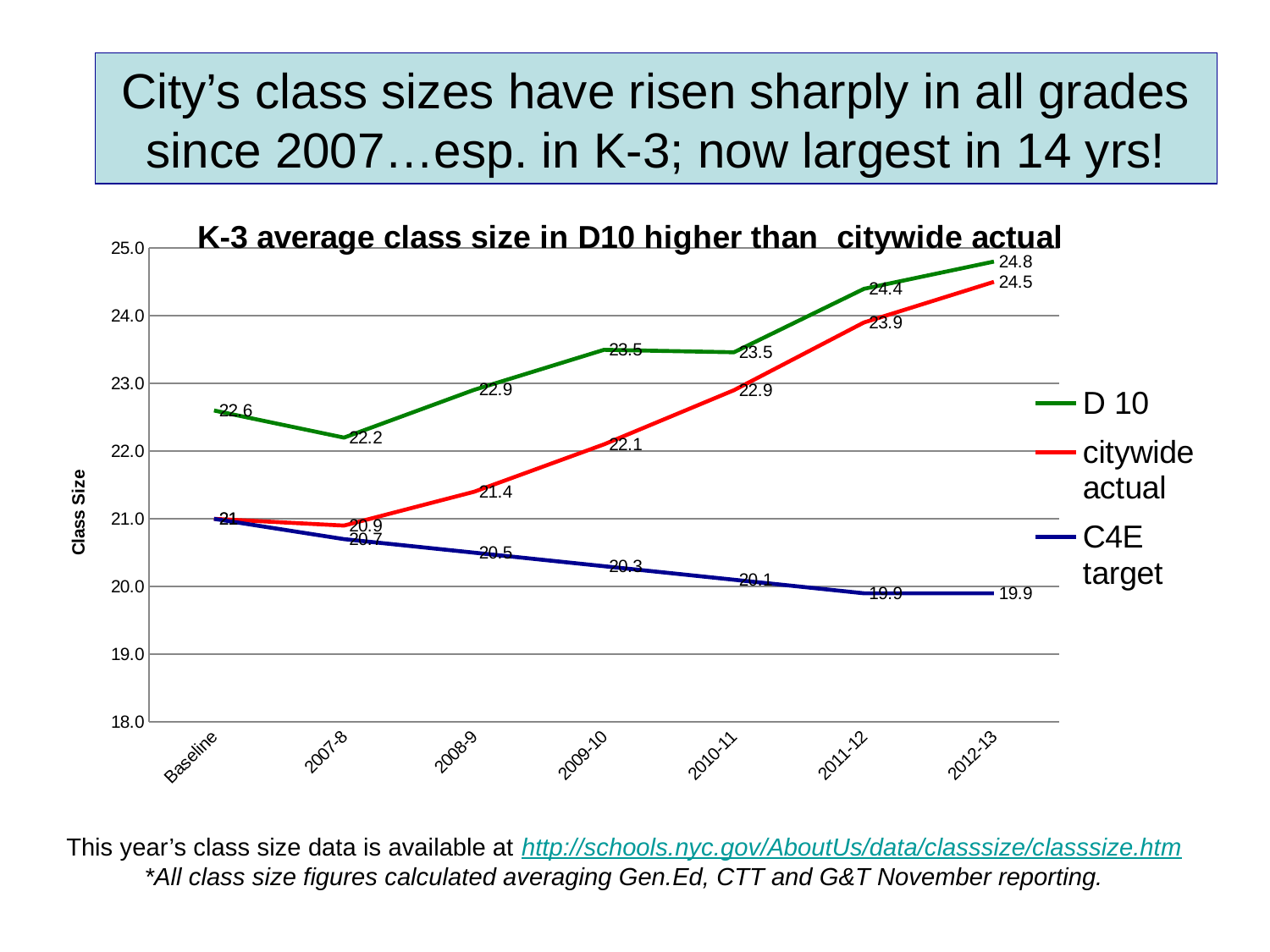
How many series does the legend list? 3 In which year is the citywide actual series at its lowest? 2007-8 In which year is the D 10 series at its highest? 2012-13 How many time points are plotted on the x axis? 7 Is the C4E target value for 2012-13 greater or less than 20.0? less What is the difference between the D 10 and citywide actual values in 2012-13? 0.3 What is the D 10 value for 2012-13? 24.8 What kind of chart is shown? line chart Does the C4E target series rise or fall from Baseline to 2012-13? fall What is the C4E target value for 2008-9? 20.5 Which is larger in 2009-10, D 10 or citywide actual? D 10 What is the citywide actual value for 2010-11? 22.9